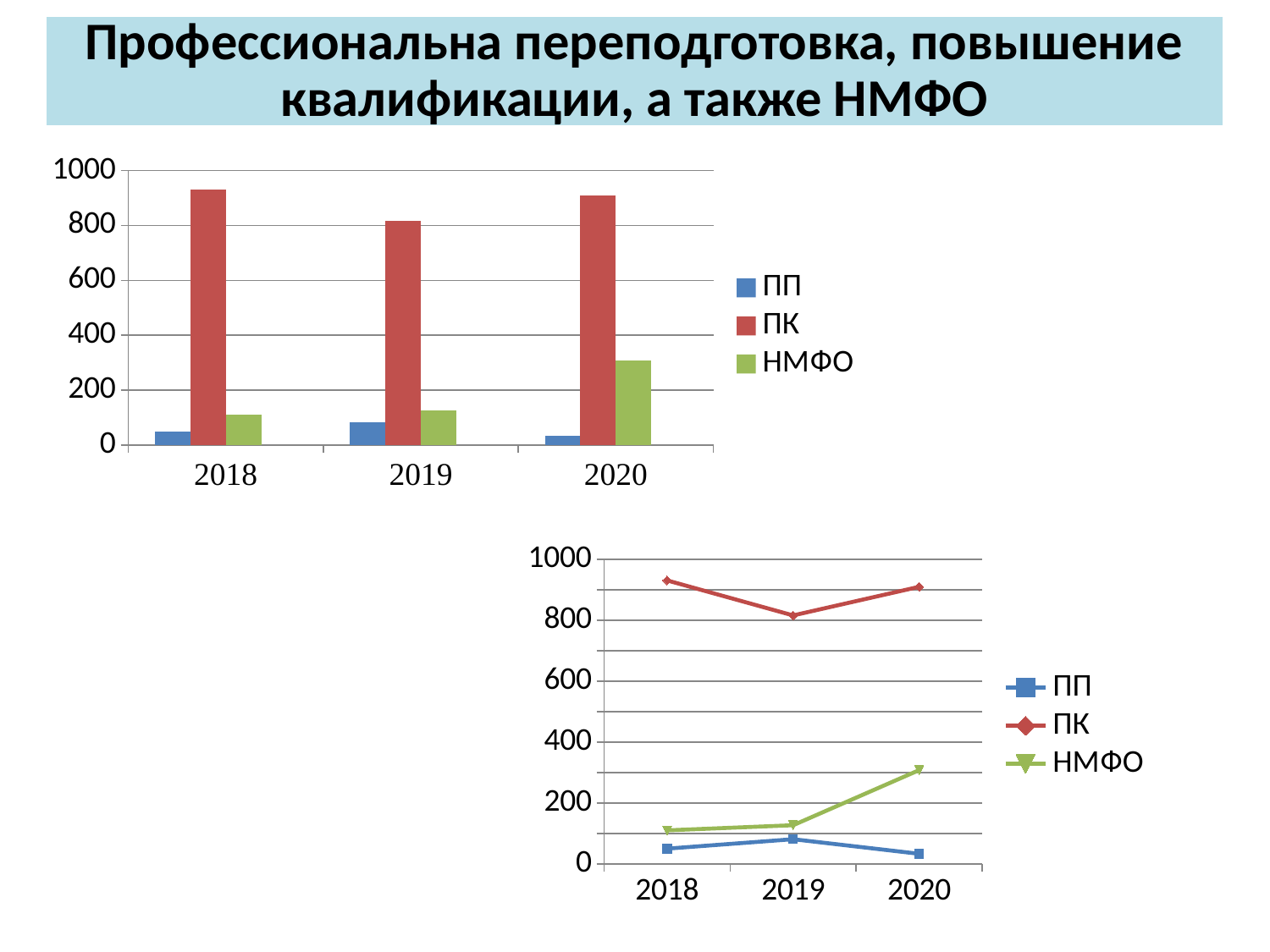
What type of chart is the top chart on the slide? bar chart What type of chart is the bottom chart on the slide? line chart In the bottom line chart, is the value for ПП in 2019 greater or less than 200? less In the top bar chart, which series has the highest value in every year? ПК In the top bar chart, in which year is the ПК bar lowest? 2019 In the bottom line chart, does the НМФО line rise or fall from 2018 to 2020? rises In the top bar chart, in which year is the НМФО bar highest? 2020 How many years are shown on the x axis of the bottom line chart? 3 In the top bar chart, is the value for ПК in 2018 greater or less than 800? greater How many series does the legend of the top bar chart list? 3 In the bottom line chart, is the value for НМФО in 2020 greater or less than 200? greater In the top bar chart, which is larger in 2020: ПП or НМФО? НМФО